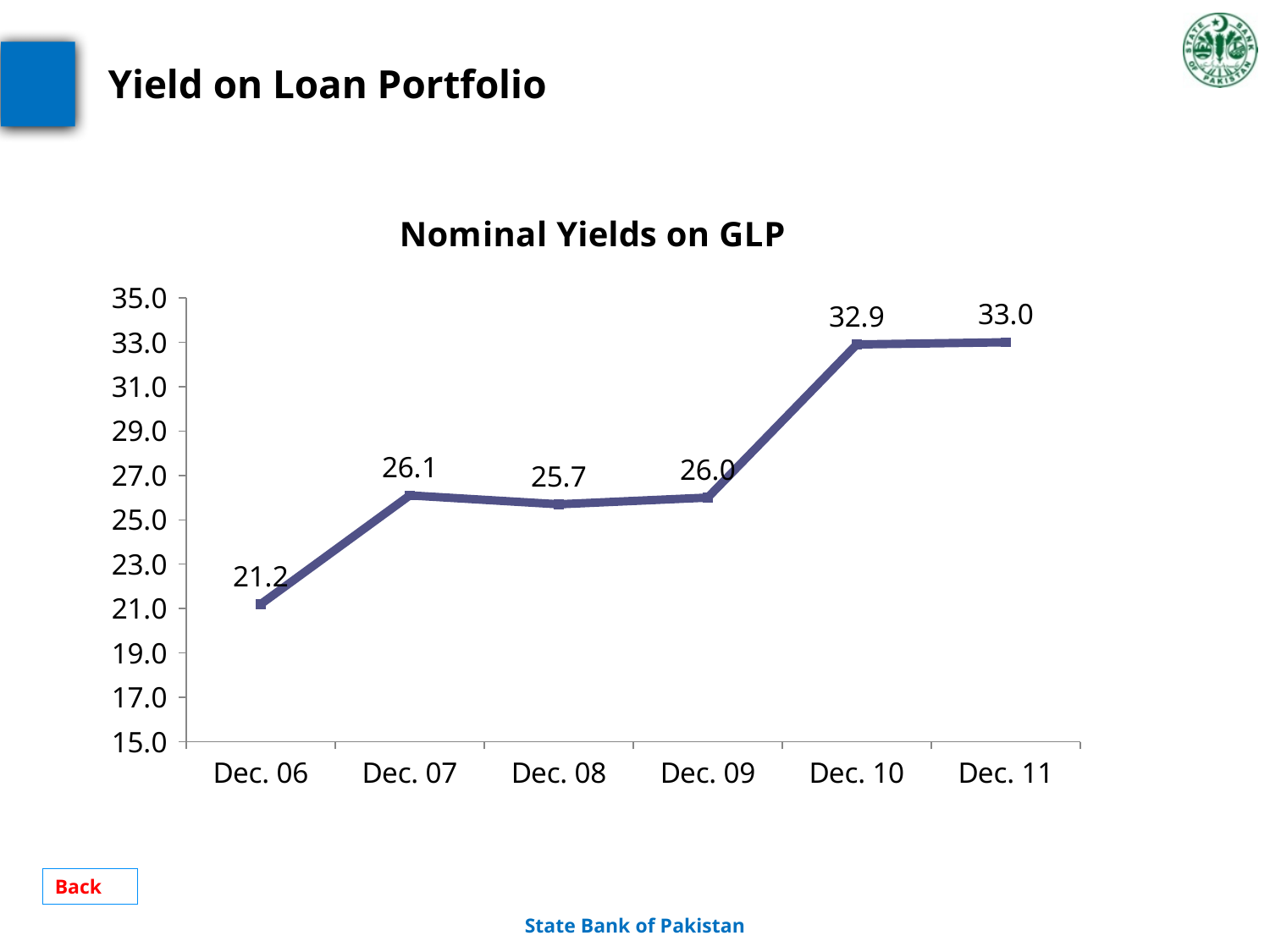
What is the nominal yield on GLP for Dec. 10? 32.9 What is the difference between the nominal yield in Dec. 10 and Dec. 09? 6.9 Which is larger, the nominal yield in Dec. 07 or in Dec. 08? Dec. 07 Which period has the lowest nominal yield on GLP? Dec. 06 What is the difference between the nominal yield in Dec. 07 and Dec. 06? 4.9 What is the nominal yield on GLP for Dec. 06? 21.2 Is the nominal yield for Dec. 09 greater or less than 27.0? less Which period has the highest nominal yield on GLP? Dec. 11 What is the nominal yield on GLP for Dec. 08? 25.7 What is the title of the chart? Nominal Yields on GLP What kind of chart is shown on the slide? line chart How many data points are plotted on the chart? 6